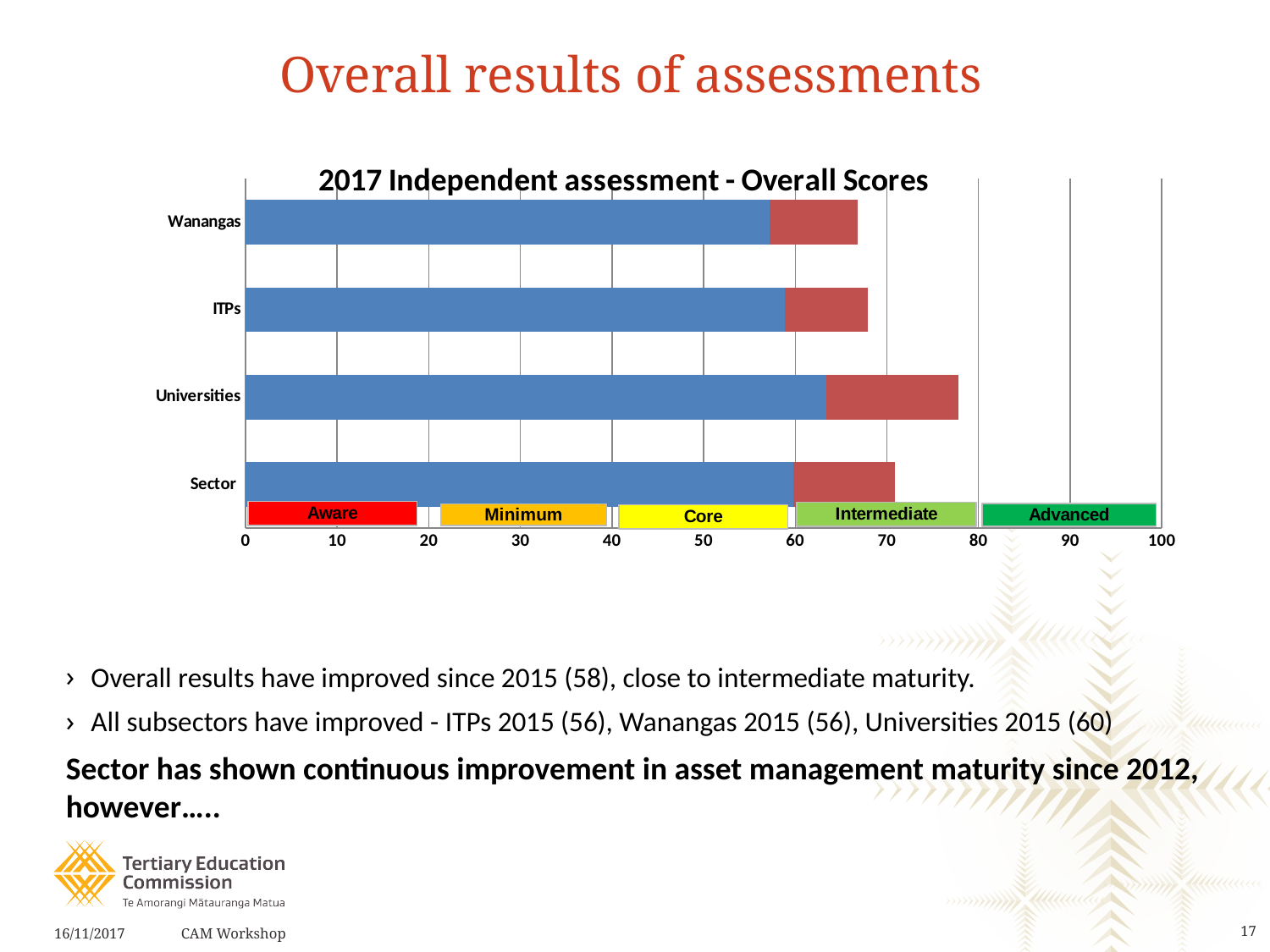
Is the blue segment for Wanangas greater or less than 60? less Which has a longer overall bar, Universities or Wanangas? Universities Is the total bar length for Universities greater or less than 70? greater Is the total bar length for Wanangas greater or less than 70? less Which category has the longest overall bar? Universities What is the title of the chart? 2017 Independent assessment - Overall Scores What are the five maturity bands labelled along the bottom of the chart? Aware, Minimum, Core, Intermediate, Advanced What kind of chart is shown on the slide? Bar chart How many categories are plotted on the chart? 4 Which has a longer overall bar, Universities or Sector? Universities